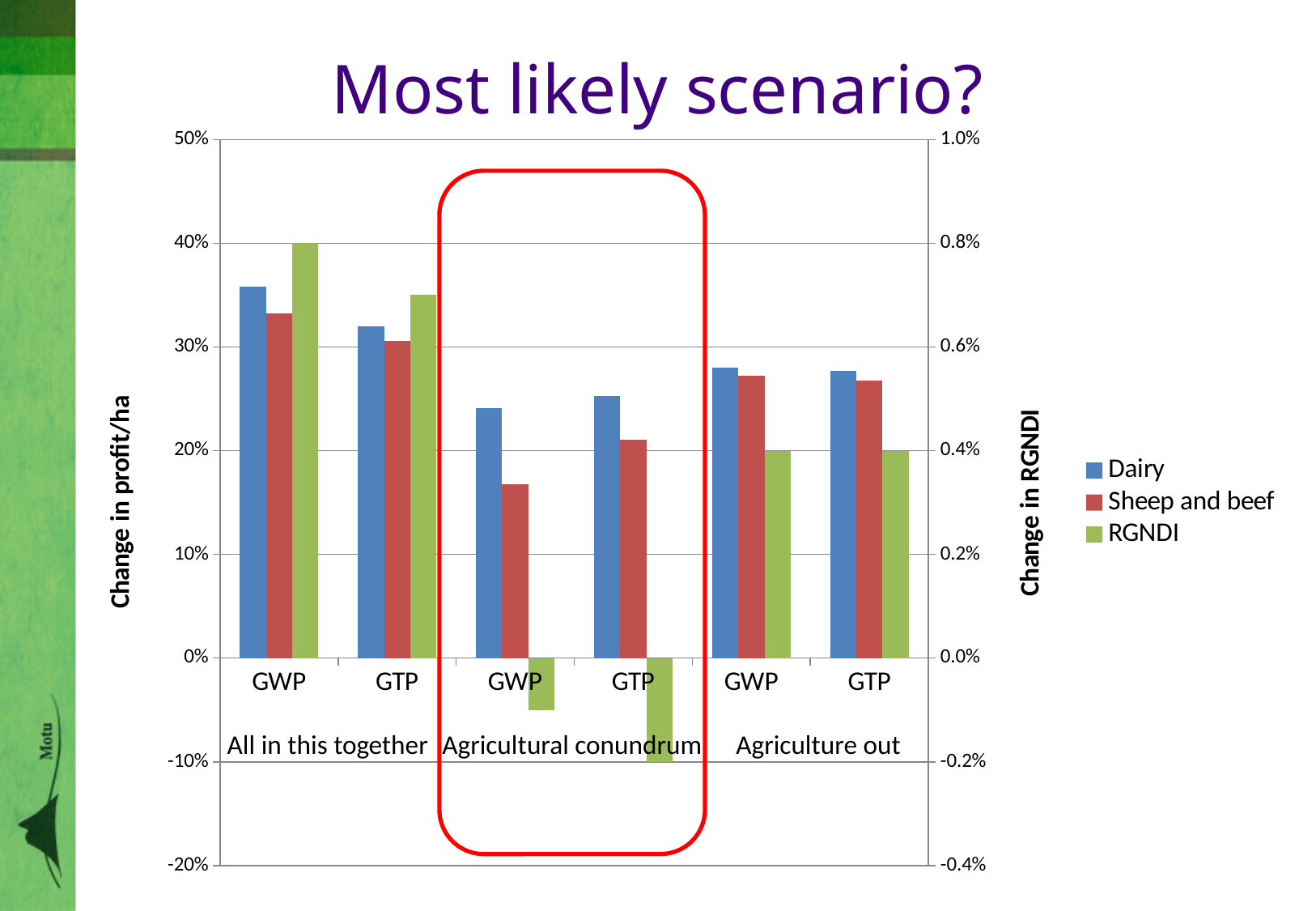
Which scenario is outlined with a red box on the chart? Agricultural conundrum How many scenario groups are shown along the x axis? 3 Which category has the highest Dairy bar? GWP under All in this together Is the Dairy value for GWP under 'All in this together' greater or less than 30%? greater What kind of chart is shown on the slide? Bar chart Which category has the lowest RGNDI bar? GTP under Agricultural conundrum Is the Sheep and beef value for GWP under 'Agriculture out' greater or less than 30%? less Is the Dairy value for GTP under 'Agricultural conundrum' greater or less than 20%? greater How many GWP/GTP category groups of bars are plotted in total? 6 How many series does the legend list? 3 Under 'Agricultural conundrum' GWP, which is larger: Dairy or Sheep and beef? Dairy